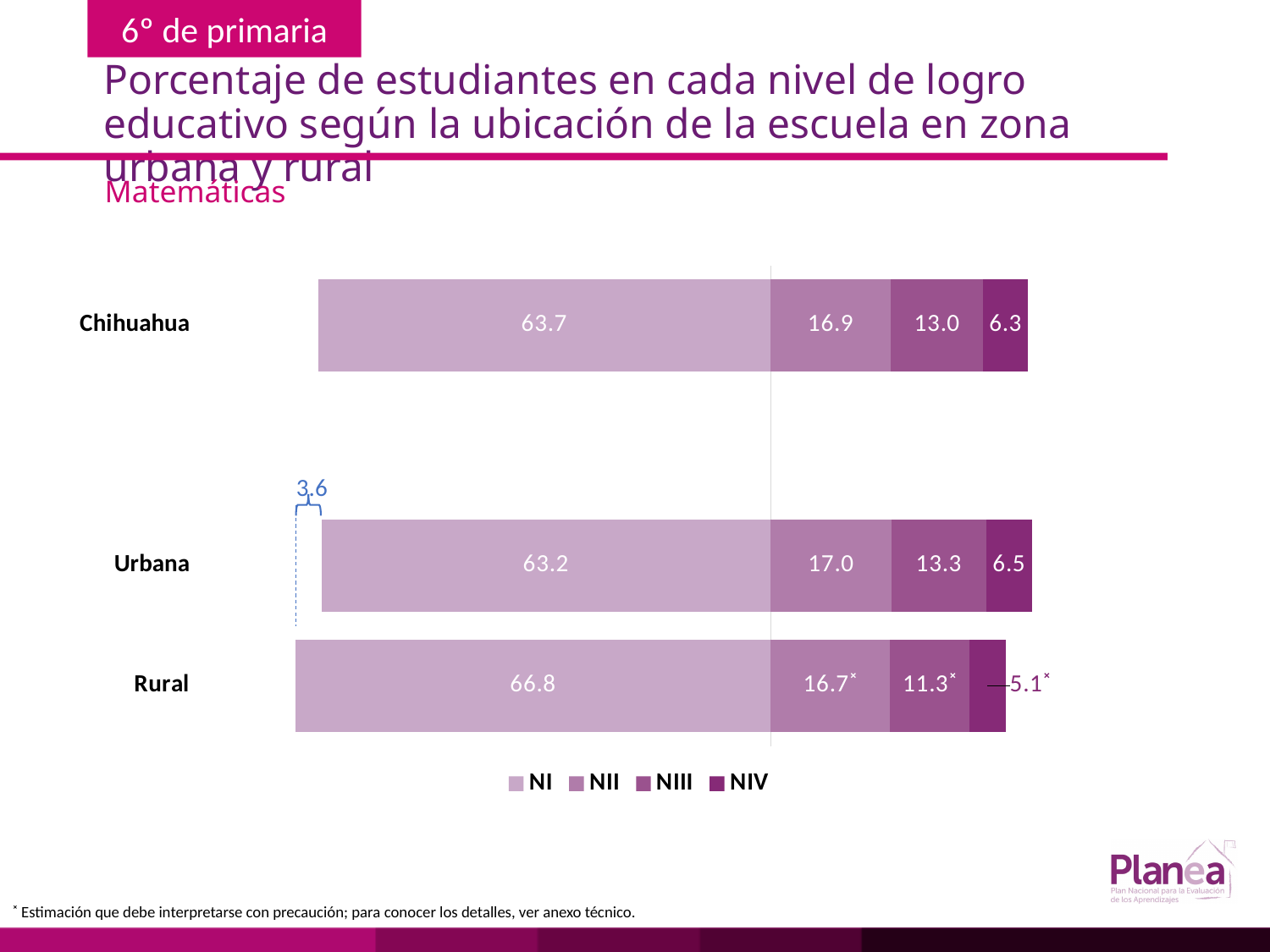
What is the NIII value for Chihuahua? 13.0 What is the NIV value for Rural? 5.1 What is the NII value for Urbana? 17.0 What kind of chart is shown on the slide? Stacked bar chart What is the NI value for Chihuahua? 63.7 What is the total of the stacked bar for Urbana? 100.0 Which is larger, the NIII value for Urbana or the NIII value for Rural? Urbana Which category has the lowest NIV value? Rural How many series does the legend list? 4 What is the difference between the NI values for Rural and Urbana? 3.6 Which category has the highest NI value? Rural How many categories (bars) are plotted in the chart? 3